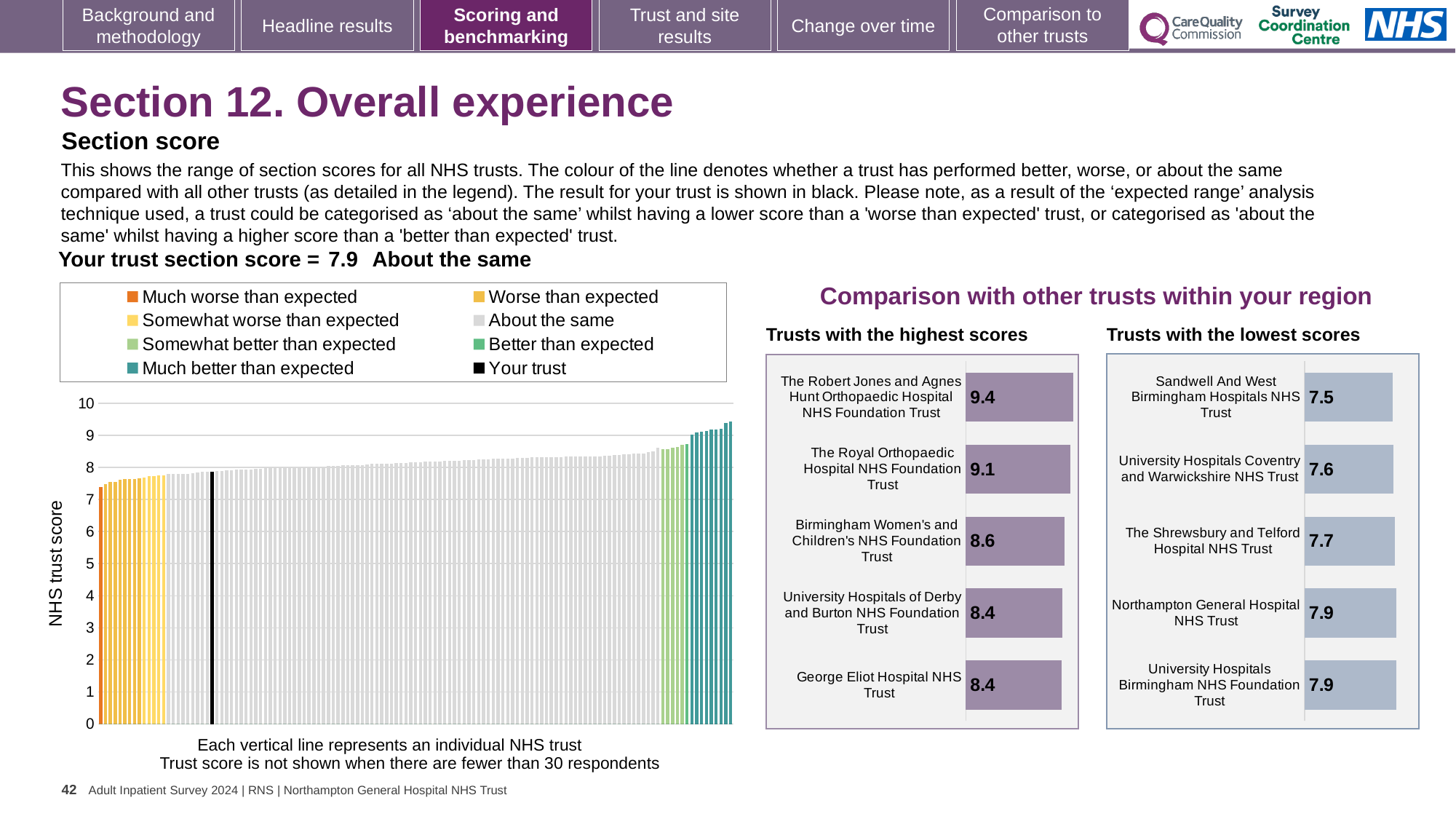
On the 'Trusts with the highest scores' chart, which trust has the highest score? The Robert Jones and Agnes Hunt Orthopaedic Hospital NHS Foundation Trust On the 'Trusts with the lowest scores' chart, what is the score for Sandwell And West Birmingham Hospitals NHS Trust? 7.5 On the 'Trusts with the highest scores' chart, what is the score for The Robert Jones and Agnes Hunt Orthopaedic Hospital NHS Foundation Trust? 9.4 What kind of chart is the 'Trusts with the lowest scores' chart? bar chart On the 'Trusts with the lowest scores' chart, which trust has the lowest score? Sandwell And West Birmingham Hospitals NHS Trust How many trusts are shown on the 'Trusts with the highest scores' chart? 5 On the 'Trusts with the lowest scores' chart, which has the higher score: University Hospitals Coventry and Warwickshire NHS Trust or The Shrewsbury and Telford Hospital NHS Trust? The Shrewsbury and Telford Hospital NHS Trust On the main NHS trust score chart, how many entries does the legend list? 8 On the 'Trusts with the lowest scores' chart, what is the difference between the scores of Northampton General Hospital NHS Trust and Sandwell And West Birmingham Hospitals NHS Trust? 0.4 On the 'Trusts with the highest scores' chart, what is the score for Birmingham Women's and Children's NHS Foundation Trust? 8.6 On the 'Trusts with the highest scores' chart, what is the difference between the scores of The Robert Jones and Agnes Hunt Orthopaedic Hospital NHS Foundation Trust and Birmingham Women's and Children's NHS Foundation Trust? 0.8 On the main NHS trust score chart, do the values rise or fall from left to right? rise